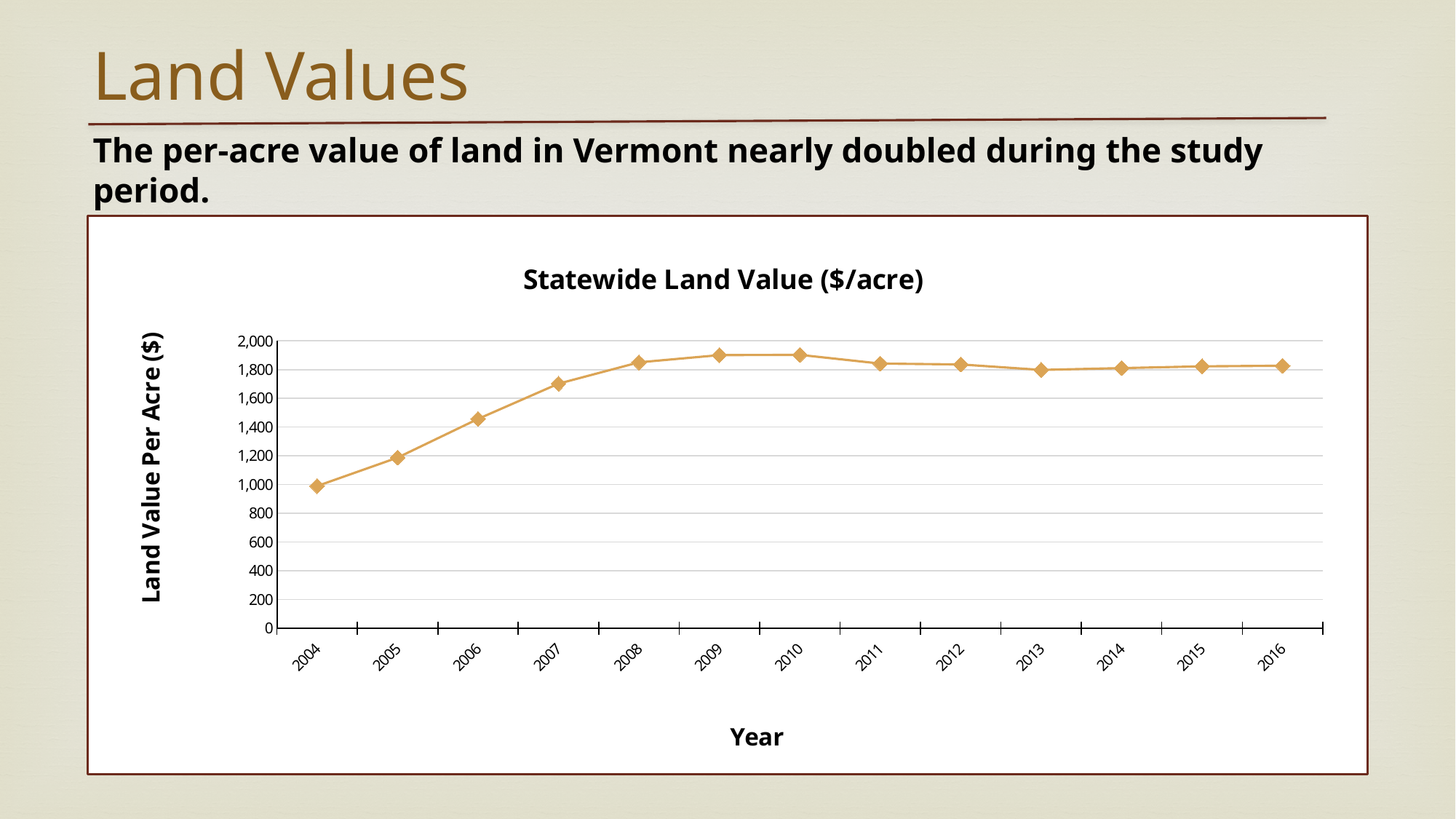
How many years are plotted on the x axis of the chart? 13 Is the land value per acre for 2005 greater or less than 1,000? greater Is the land value per acre for 2006 greater or less than 1,400? greater Is the land value per acre for 2013 greater or less than 2,000? less Which year has the higher land value per acre, 2004 or 2016? 2016 What is the title of the chart? Statewide Land Value ($/acre) Does the land value per acre rise or fall from 2004 to 2009? rise What is the label of the y axis of the chart? Land Value Per Acre ($) Which year has the lowest statewide land value per acre? 2004 Which year has the higher land value per acre, 2006 or 2008? 2008 What kind of chart is shown on the slide? line chart